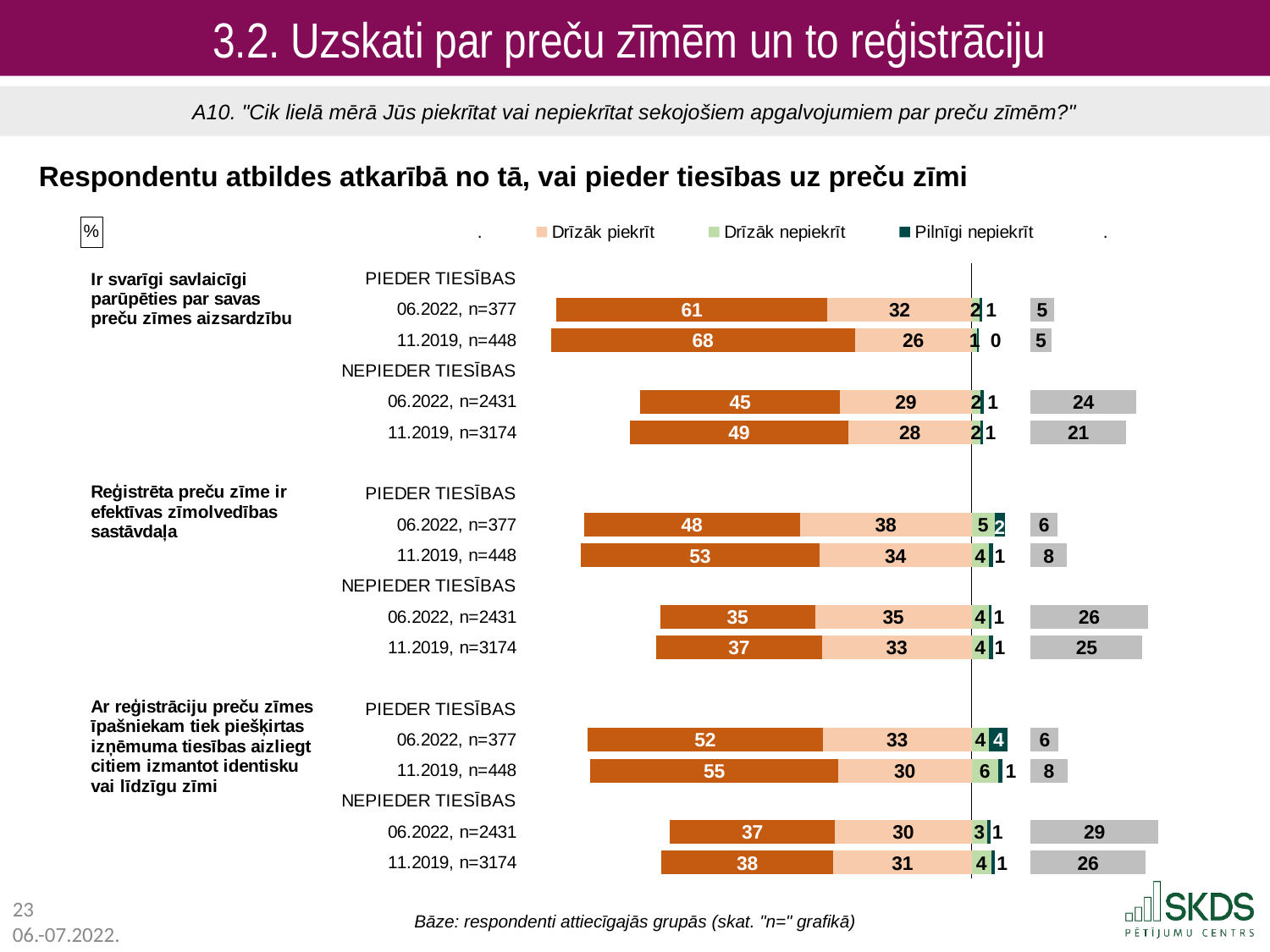
What kind of chart is shown on the slide? Stacked bar chart For the statement "Reģistrēta preču zīme ir efektīvas zīmolvedības sastāvdaļa", what is the "Drīzāk nepiekrīt" value for PIEDER TIESĪBAS, 06.2022, n=377? 5 For the statement "Ir svarīgi savlaicīgi parūpēties par savas preču zīmes aizsardzību", which row has the largest first (dark orange) segment? PIEDER TIESĪBAS, 11.2019, n=448 For the statement "Ar reģistrāciju preču zīmes īpašniekam tiek piešķirtas izņēmuma tiesības...", what is the "Pilnīgi nepiekrīt" value for PIEDER TIESĪBAS, 06.2022, n=377? 4 How many statements (groups of bars) are shown on the chart? 3 For the statement "Ar reģistrāciju preču zīmes īpašniekam tiek piešķirtas izņēmuma tiesības...", what is the difference between the grey segment values for NEPIEDER TIESĪBAS 06.2022 (29) and NEPIEDER TIESĪBAS 11.2019 (26)? 3 For the statement "Ir svarīgi savlaicīgi parūpēties par savas preču zīmes aizsardzību", what is the value of the first (dark orange) segment for NEPIEDER TIESĪBAS, 11.2019, n=3174? 49 Which legend entry is shown with the dark green colour? Pilnīgi nepiekrīt For the statement "Ar reģistrāciju preču zīmes īpašniekam tiek piešķirtas izņēmuma tiesības...", which row has the largest grey segment at the right? NEPIEDER TIESĪBAS, 06.2022, n=2431 For the statement "Reģistrēta preču zīme ir efektīvas zīmolvedības sastāvdaļa", what is the difference between the first (dark orange) segment values for PIEDER TIESĪBAS 11.2019 (53) and PIEDER TIESĪBAS 06.2022 (48)? 5 For the statement "Ir svarīgi savlaicīgi parūpēties par savas preču zīmes aizsardzību", is the "Drīzāk piekrīt" value larger for PIEDER TIESĪBAS 06.2022 or for PIEDER TIESĪBAS 11.2019? PIEDER TIESĪBAS 06.2022 For the statement "Ir svarīgi savlaicīgi parūpēties par savas preču zīmes aizsardzību", what is the "Drīzāk piekrīt" value for PIEDER TIESĪBAS, 06.2022, n=377? 32